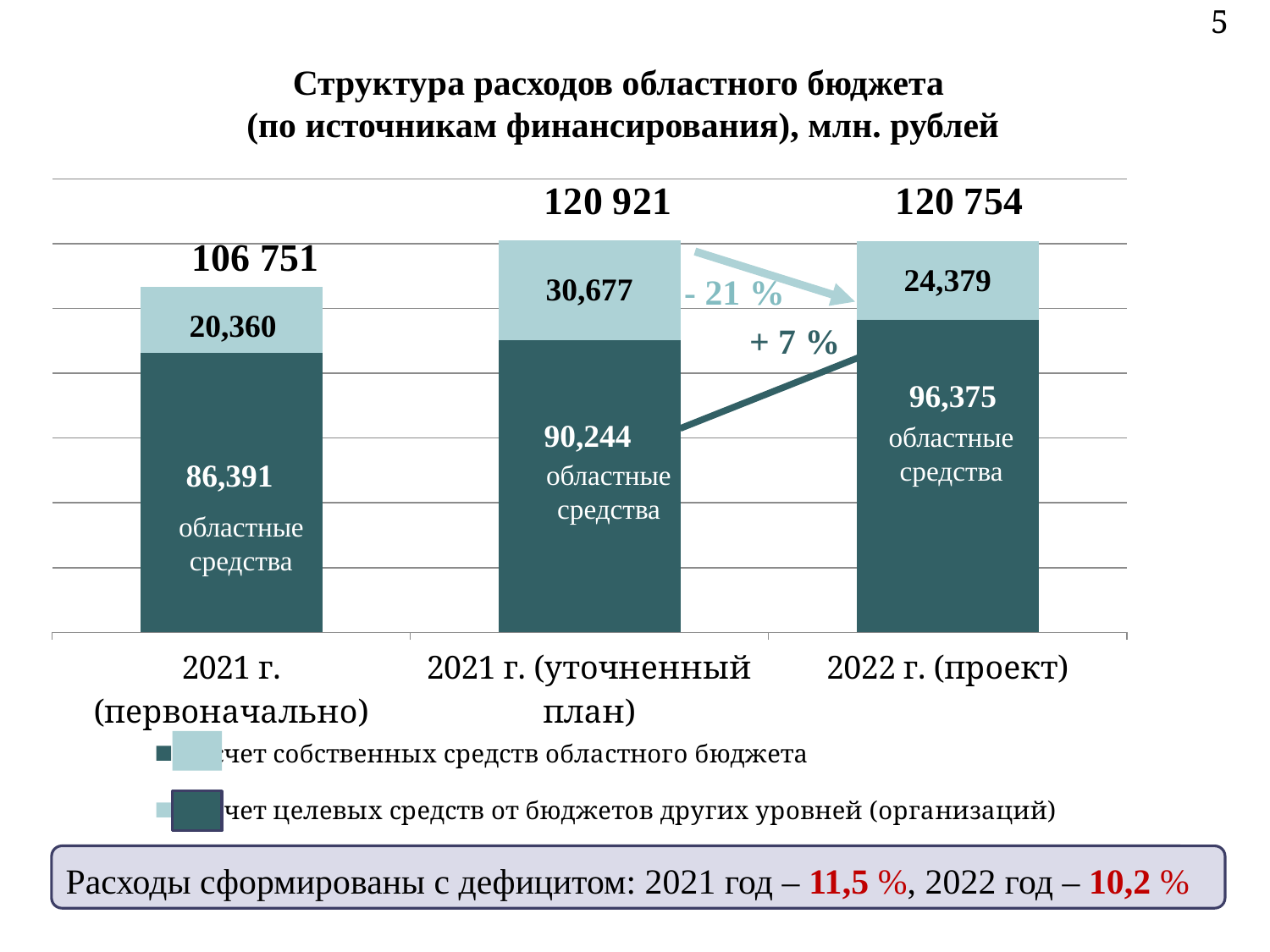
Do the values of областные средства rise or fall from left to right across the three bars? rise Which category has the lowest total? 2021 г. (первоначально) Which is larger: the upper (light) segment for 2021 г. (уточненный план) or for 2022 г. (проект)? 2021 г. (уточненный план) What is the difference between областные средства for 2022 г. (проект) and for 2021 г. (первоначально)? 9,984 What is the total shown above the bar for 2021 г. (уточненный план)? 120 921 What kind of chart is shown on the slide? stacked bar chart What is the value of областные средства for 2022 г. (проект)? 96,375 How many series does the legend list? 2 What percentage change is shown by the light arrow between the upper segments of 2021 г. (уточненный план) and 2022 г. (проект)? - 21 % How many categories (bars) are shown on the x axis? 3 Which category has the highest total? 2021 г. (уточненный план) What is the value of the upper (light) segment for 2021 г. (первоначально)? 20,360